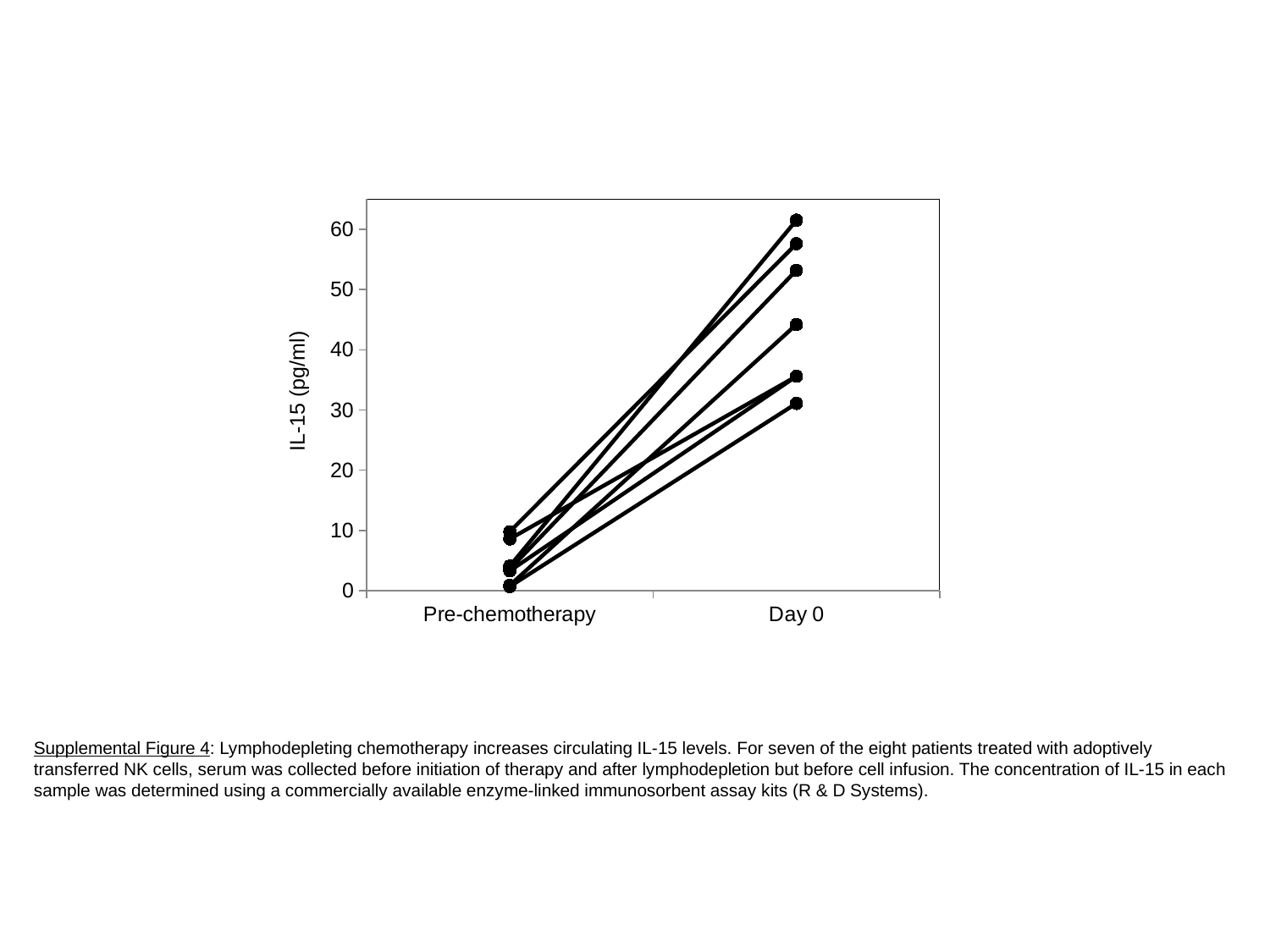
Is the highest Pre-chemotherapy value greater or less than 20? less Is the highest Day 0 value greater or less than 50? greater How many patient lines are plotted in the chart? 7 What kind of chart is shown on the slide? line chart Is the lowest Day 0 value greater or less than 20? greater Which category has the higher IL-15 values, Pre-chemotherapy or Day 0? Day 0 Do the IL-15 values rise or fall from Pre-chemotherapy to Day 0? rise What is the label of the y axis of the chart? IL-15 (pg/ml) How many categories are shown on the x axis of the chart? 2 What are the two categories on the x axis of the chart? Pre-chemotherapy and Day 0